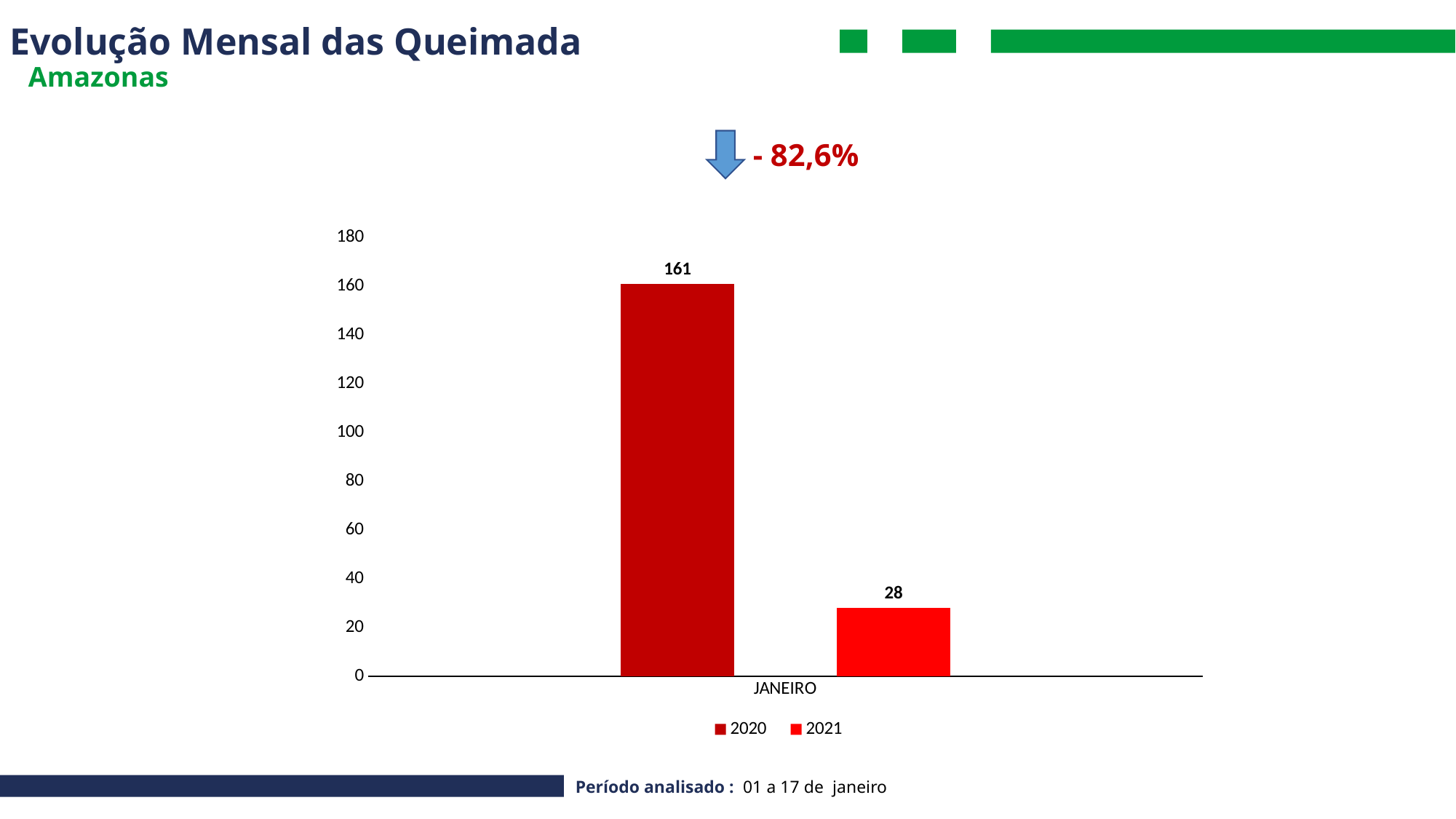
Is the value for 2021 in JANEIRO greater or less than 40? less How many series does the legend list? 2 Which series has the higher value in JANEIRO, 2020 or 2021? 2020 What percentage change is shown above the chart? - 82,6% What is the value for 2020 in JANEIRO? 161 What is the difference between the 2020 and 2021 values for JANEIRO? 133 What kind of chart is shown on the slide? bar chart What is the value for 2021 in JANEIRO? 28 Is the value for 2020 in JANEIRO greater or less than 140? greater How many categories are shown on the x axis? 1 What is the highest value shown on the y axis? 180